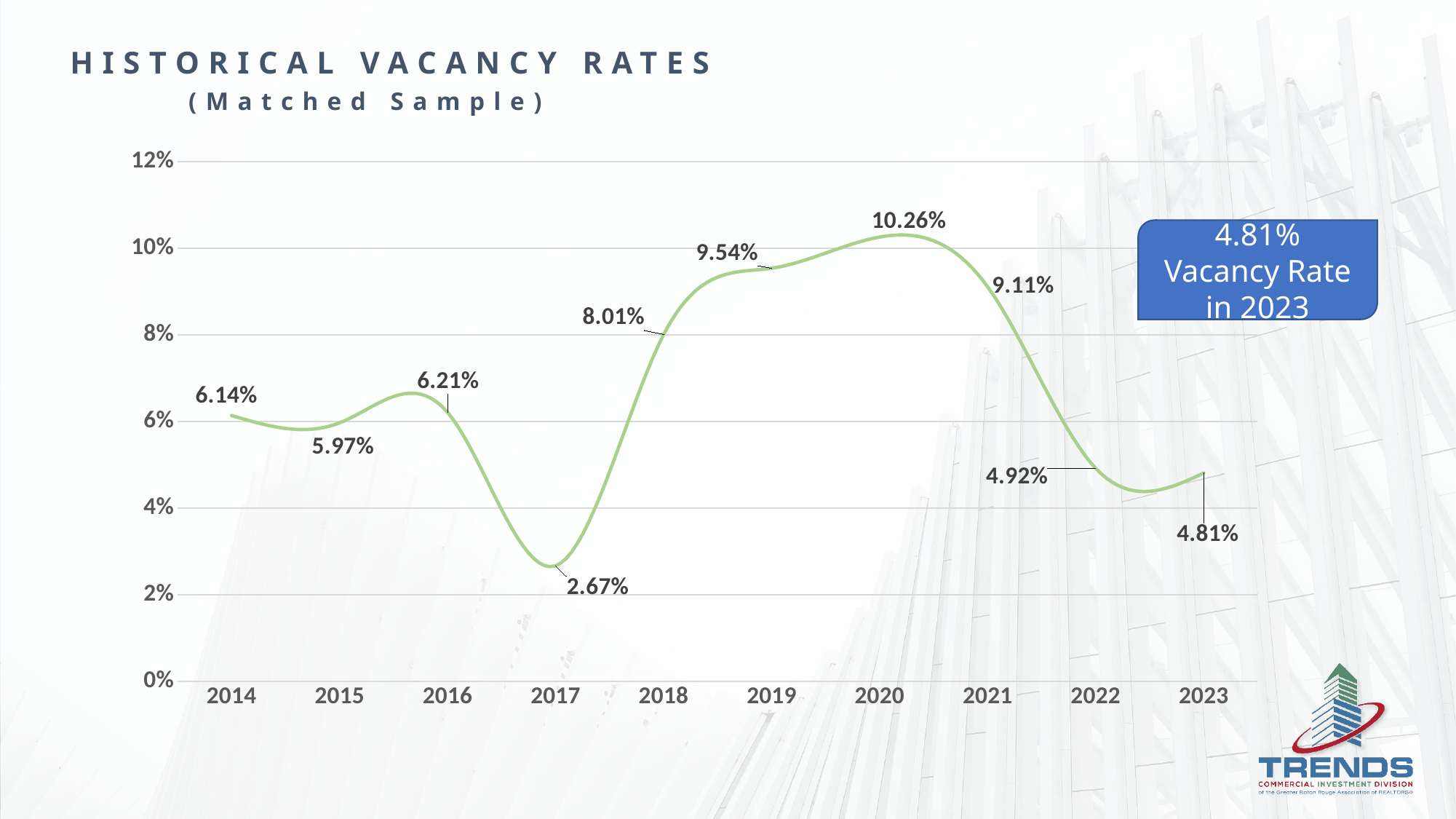
Which year had the lowest vacancy rate? 2017 Did the vacancy rate rise or fall from 2020 to 2023? fall Which year had the highest vacancy rate? 2020 What is the difference between the vacancy rates in 2018 and 2017? 5.34% Is the vacancy rate for 2022 greater or less than 6%? less What kind of chart is shown on the slide? line chart What was the vacancy rate in 2014? 6.14% How many years are shown on the x axis? 10 Which year had a higher vacancy rate, 2019 or 2021? 2019 What was the vacancy rate in 2017? 2.67% What was the vacancy rate in 2020? 10.26% What is the difference between the vacancy rates in 2020 and 2023? 5.45%